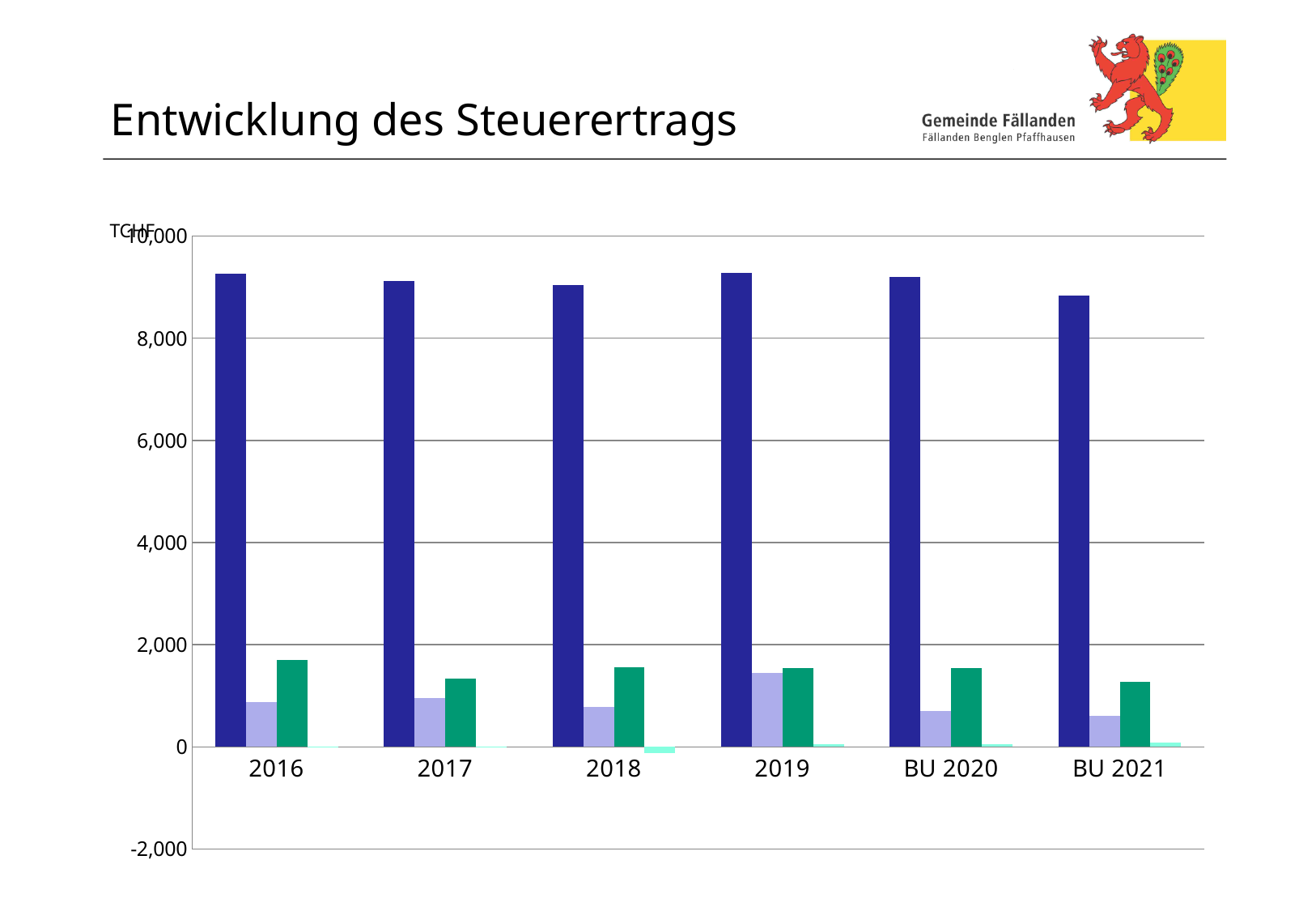
Is the value of the dark blue bar for 2016 greater or less than 8,000? greater Is the value of the light purple bar for 2019 greater or less than 2,000? less What unit label is shown at the top of the vertical axis? TCHF What kind of chart is shown on the slide? bar chart What is the title of the chart? Entwicklung des Steuerertrags In which category is the dark blue bar the lowest? BU 2021 How many categories are shown on the x axis of the chart? 6 Is the value of the light cyan bar for 2018 greater or less than 0? less How many bars are plotted for each category in the chart? 4 In which category is the light purple bar the highest? 2019 For 2016, which is larger: the green bar or the light purple bar? the green bar